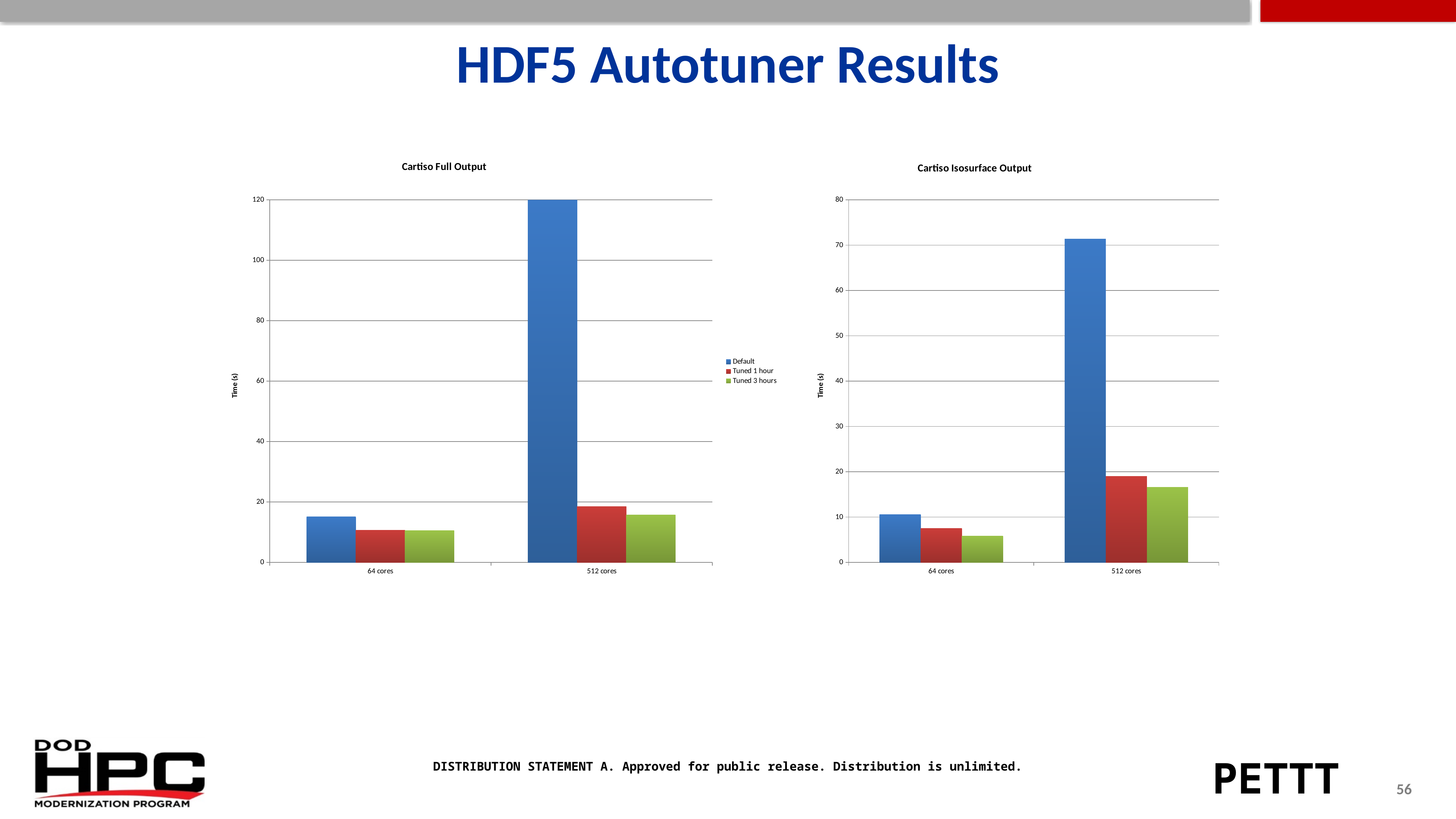
In the "Cartiso Full Output" chart, does the Default series rise or fall from 64 cores to 512 cores? rise In the "Cartiso Isosurface Output" chart, is the Default value at 512 cores greater or less than 70? greater In the "Cartiso Isosurface Output" chart, which series has the lowest value at 64 cores? Tuned 3 hours In the "Cartiso Full Output" chart, is the Default value at 512 cores greater or less than 100? greater In the "Cartiso Full Output" chart, how many core-count categories are shown on the x axis? 2 How many series does the legend list for the charts on this slide? 3 What is the y-axis label on the "Cartiso Isosurface Output" chart? Time (s) In the "Cartiso Full Output" chart, which series has the highest value at 512 cores? Default In the "Cartiso Isosurface Output" chart, is the Tuned 3 hours value at 512 cores greater or less than 20? less What kind of chart is the "Cartiso Full Output" chart? bar chart In the "Cartiso Isosurface Output" chart, which is larger at 512 cores: Tuned 1 hour or Tuned 3 hours? Tuned 1 hour